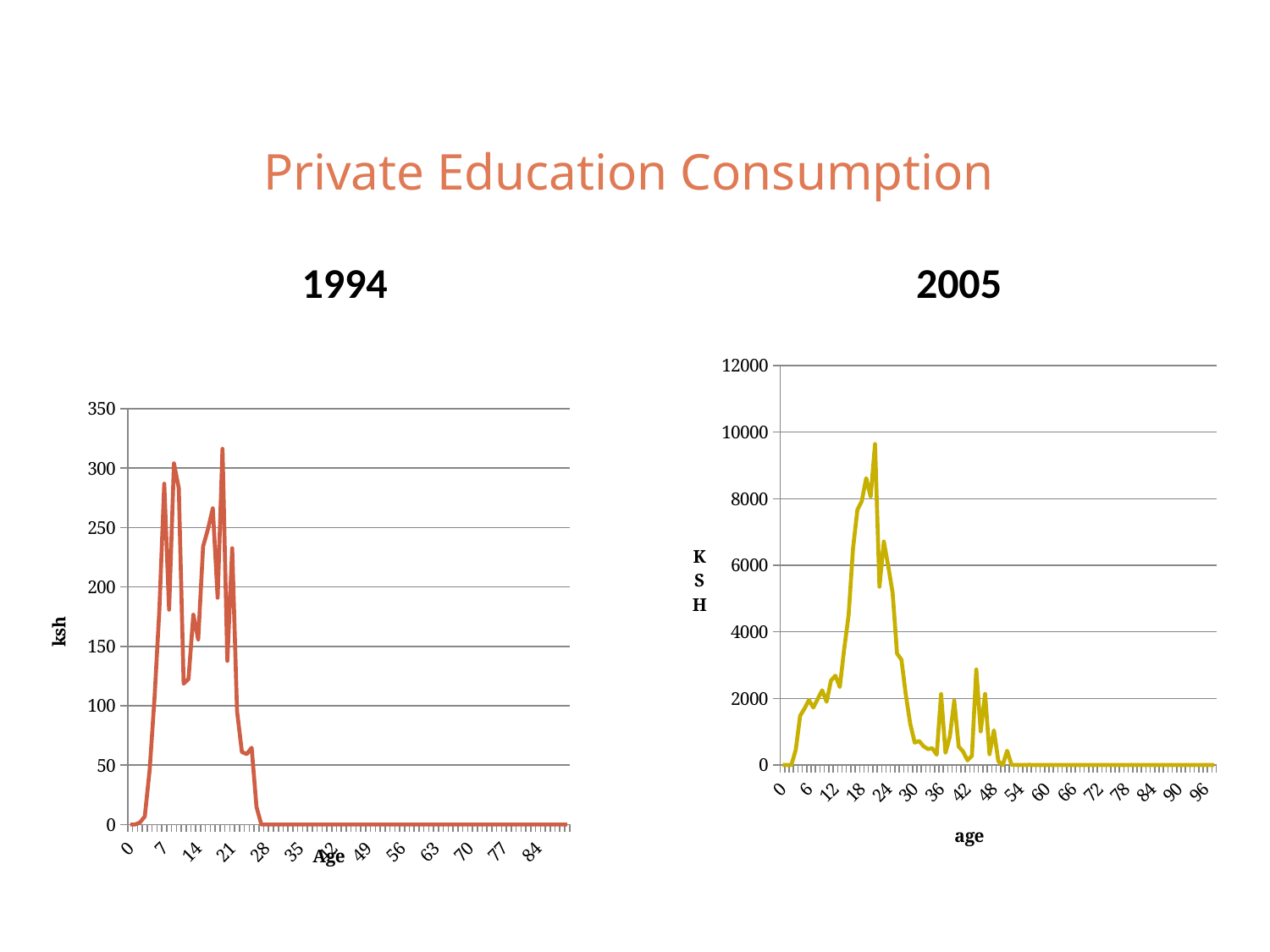
On the 2005 chart, is the value at age 72 greater or less than 2000? less What kind of chart is the 2005 chart? line chart On the 2005 chart, do the values rise or fall between age 24 and age 30? fall On the 2005 chart, is the highest value of the line greater or less than 8000? greater On the 1994 chart, do the values rise or fall between age 21 and age 28? fall On the 1994 chart, is the value at age 49 greater or less than 50? less What is the y-axis label on the 1994 chart? ksh What is the overall title of the slide above the two charts? Private Education Consumption What kind of chart is the 1994 chart? line chart